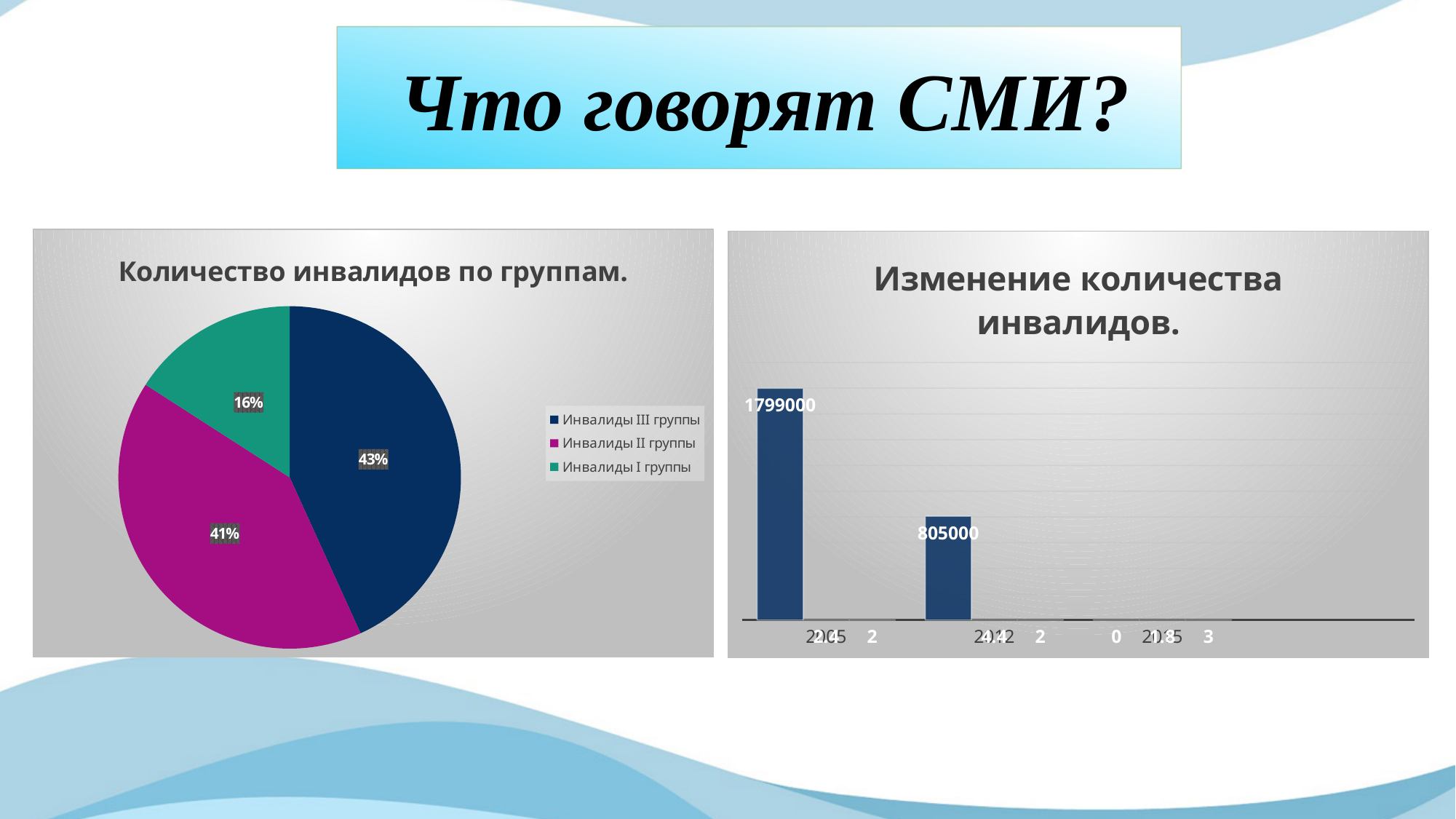
In the pie chart "Количество инвалидов по группам.", which group has the largest slice? Инвалиды III группы What kind of chart is the right chart titled "Изменение количества инвалидов."? bar chart What kind of chart is the left chart titled "Количество инвалидов по группам."? pie chart In the pie chart "Количество инвалидов по группам.", what share is shown for Инвалиды II группы? 41% In the pie chart "Количество инвалидов по группам.", what is the difference between the shares of Инвалиды III группы and Инвалиды I группы? 27% In the bar chart "Изменение количества инвалидов.", what is the difference between the first bar (1799000) and the second bar (805000)? 994000 In the bar chart "Изменение количества инвалидов.", what is the value of the tallest bar? 1799000 In the pie chart "Количество инвалидов по группам.", how many entries does the legend list? 3 In the pie chart "Количество инвалидов по группам.", what share is shown for Инвалиды I группы? 16% In the pie chart "Количество инвалидов по группам.", which group has the smallest slice? Инвалиды I группы In the pie chart "Количество инвалидов по группам.", what colour is the slice for Инвалиды II группы? magenta In the pie chart "Количество инвалидов по группам.", what share is shown for Инвалиды III группы? 43%